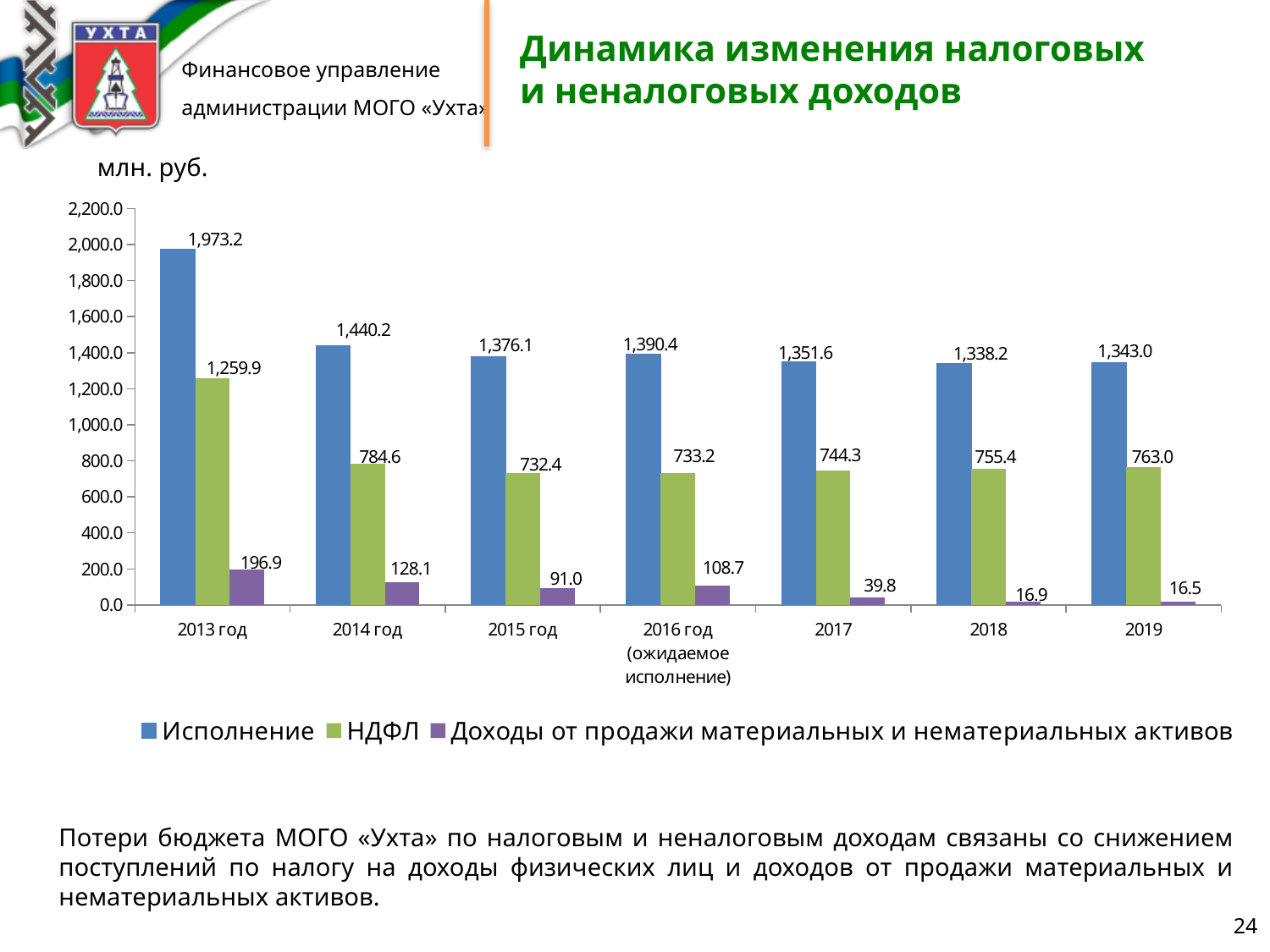
In which year is the Доходы от продажи материальных и нематериальных активов value lowest? 2019 In which year is the Исполнение value highest? 2013 год How many year categories are shown on the x axis? 7 Does the Доходы от продажи материальных и нематериальных активов series generally rise or fall from 2013 год to 2019? Fall What is the value of НДФЛ for 2019? 763.0 What is the value of Доходы от продажи материальных и нематериальных активов for 2016 год (ожидаемое исполнение)? 108.7 Which is larger, the НДФЛ value for 2014 год or for 2015 год? 2014 год What unit is stated above the chart? млн. руб. What is the value of Исполнение for 2013 год? 1,973.2 How many series does the legend list? 3 What kind of chart is shown on the slide? Bar chart What is the difference between the Исполнение values for 2013 год and 2014 год? 533.0